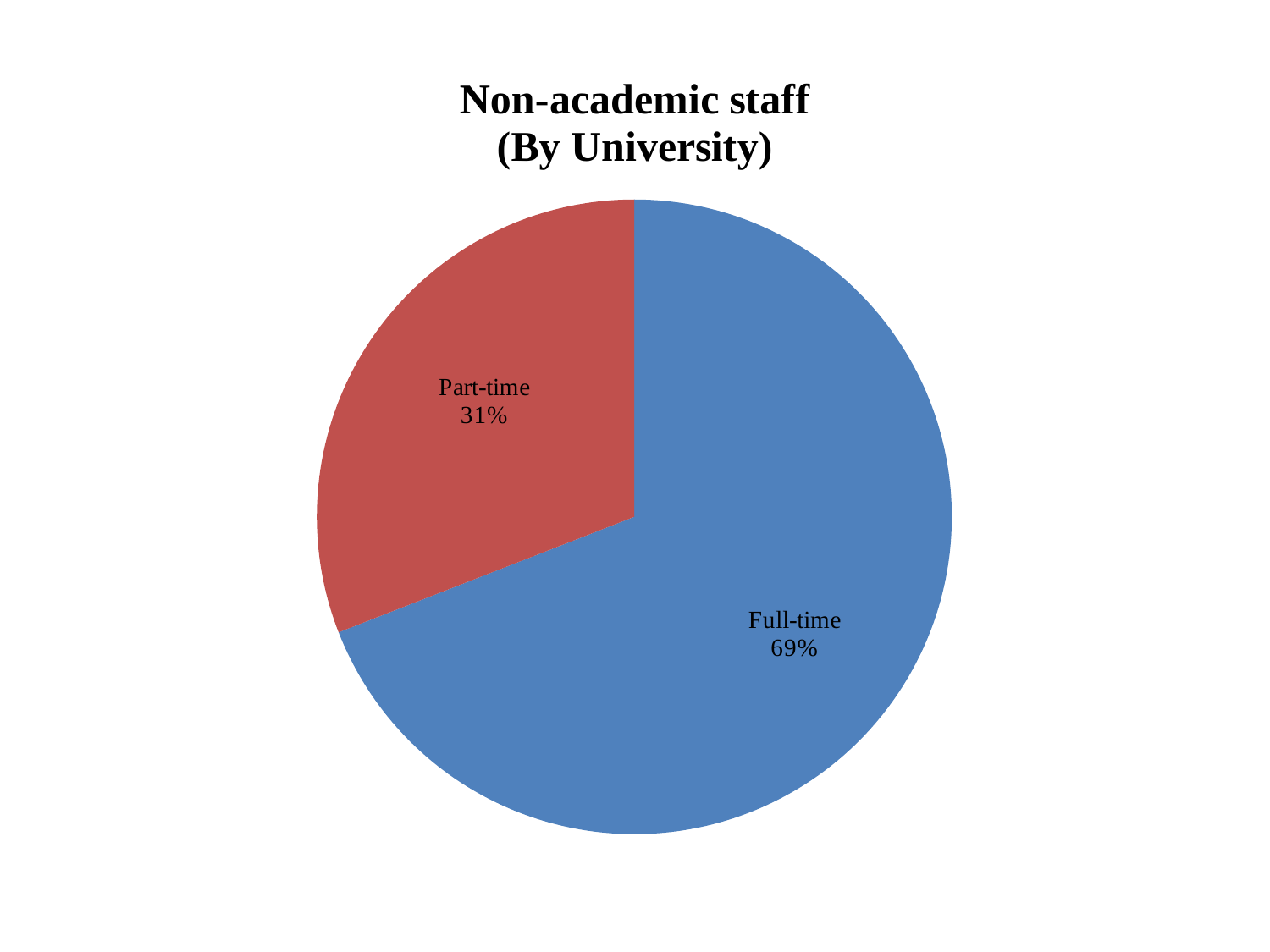
What is the title of the chart? Non-academic staff (By University) Which category has the smallest share of the pie? Part-time What is the difference in percentage points between the Full-time and Part-time shares? 38 What colour is the Part-time slice? Red Which is larger, the Full-time share or the Part-time share? Full-time Which category has the largest share of the pie? Full-time What kind of chart is shown on the slide? Pie chart How many categories are shown in the pie chart? 2 What share of non-academic staff is Full-time? 69% What share of non-academic staff is Part-time? 31%